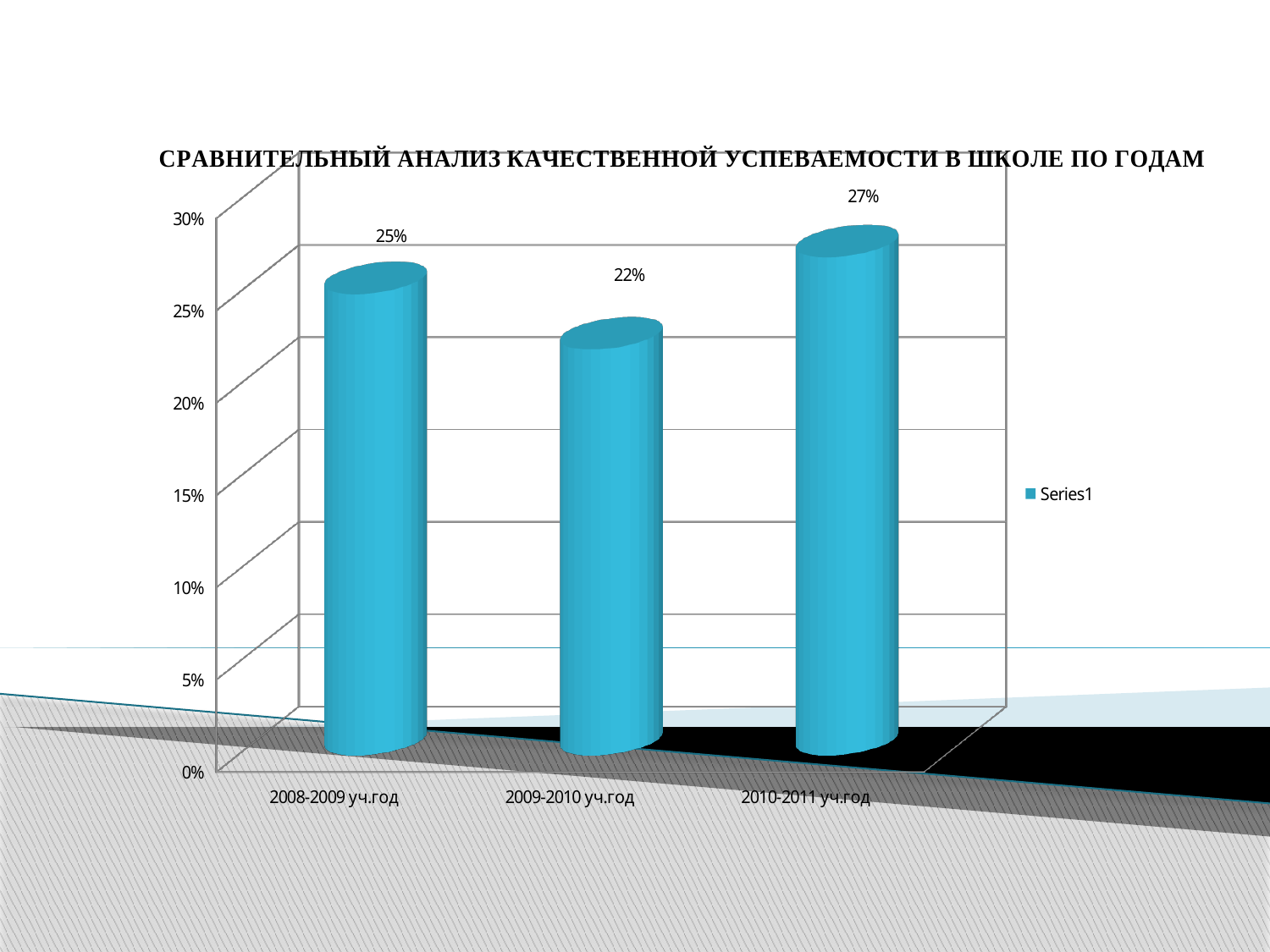
Which is larger, the value for 2008-2009 уч.год or 2010-2011 уч.год? 2010-2011 уч.год Which school year has the lowest value? 2009-2010 уч.год What is the value for 2009-2010 уч.год? 22% What is the legend entry shown on the chart? Series1 What is the difference between the values for 2008-2009 уч.год and 2009-2010 уч.год? 3% What kind of chart is shown on the slide? bar chart How many school years are shown on the chart? 3 What is the value for 2008-2009 уч.год? 25% What is the difference between the values for 2010-2011 уч.год and 2009-2010 уч.год? 5% Which school year has the highest value? 2010-2011 уч.год Is the value for 2009-2010 уч.год greater or less than 25%? less What is the value for 2010-2011 уч.год? 27%